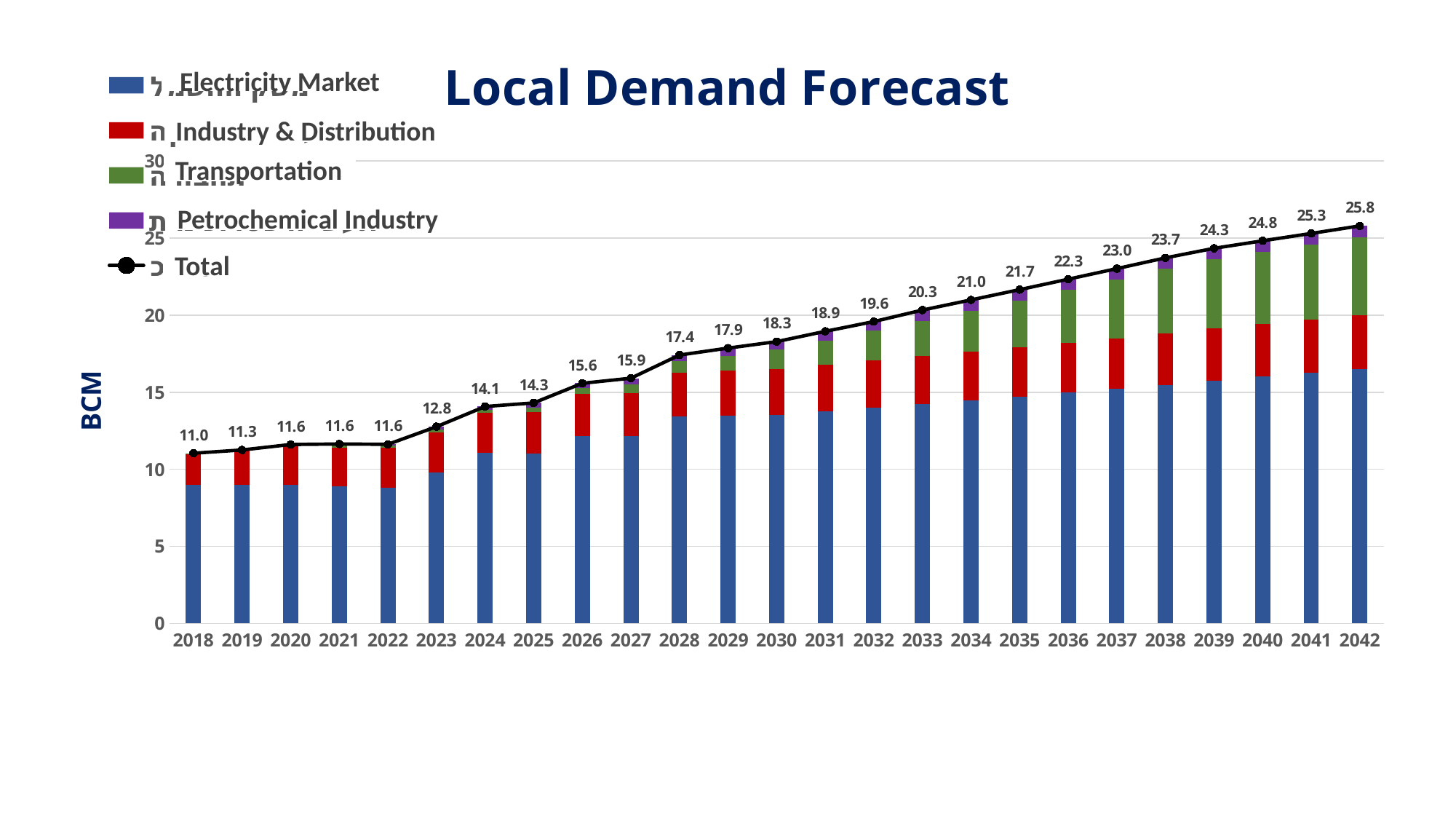
Which is larger, the Total value for 2028 or the Total value for 2027? 2028 How many series does the legend list? 5 Which year has the highest Total value? 2042 What is the Total value shown for 2018? 11.0 How many years are shown on the x axis? 25 Is the value for Electricity Market in 2042 greater or less than 15? greater What is the title of the chart? Local Demand Forecast Is the value for Electricity Market in 2018 greater or less than 10? less Do the Total values rise or fall from 2018 to 2042? rise What is the Total value shown for 2030? 18.3 What is the difference between the Total value for 2042 and the Total value for 2018? 14.8 Which year has the lowest Total value? 2018